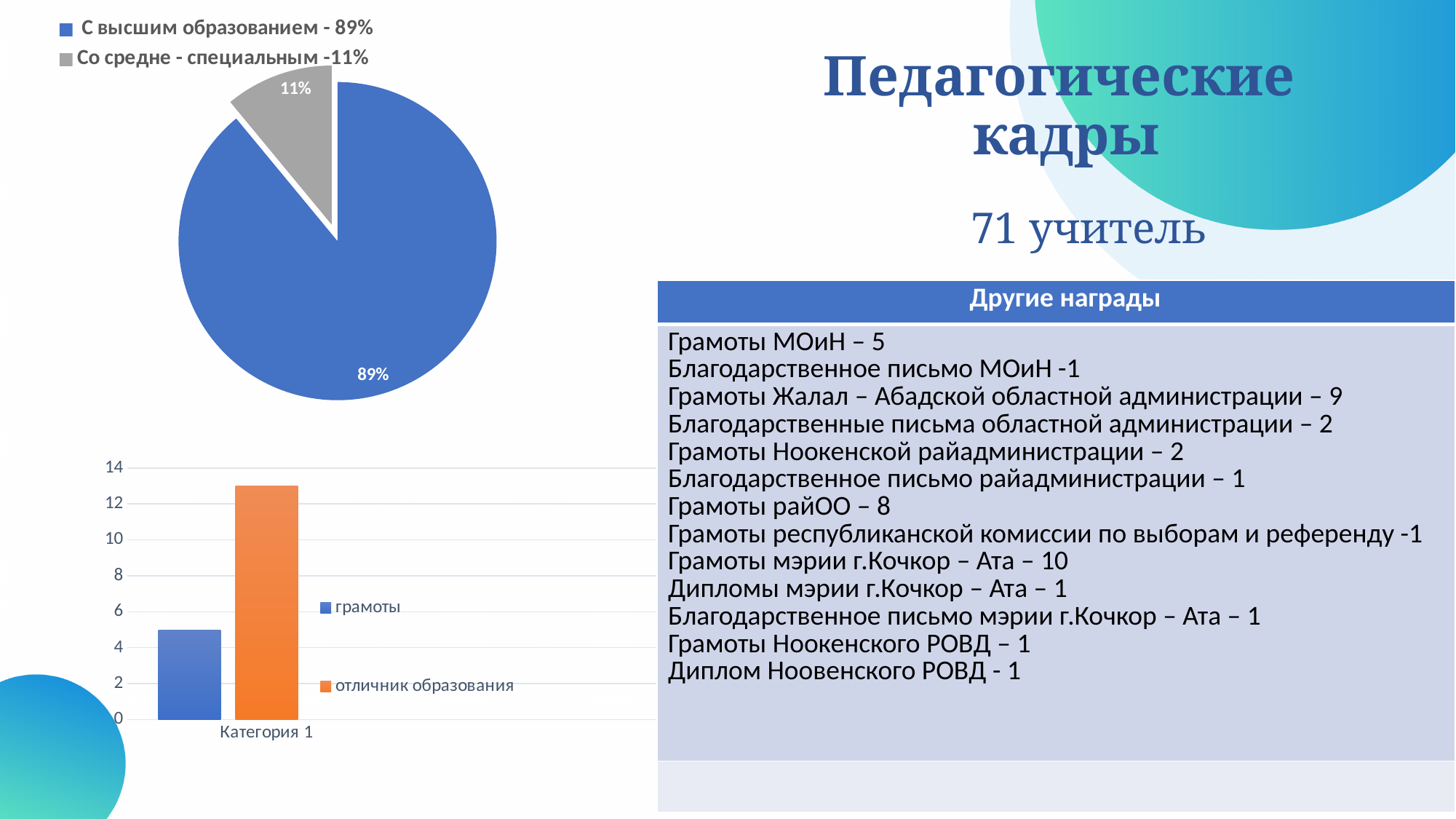
What kind of chart is the top-left chart on the slide? pie chart In the pie chart, what share is labelled for the slice 'Со средне - специальным'? 11% In the bar chart, is the value for 'грамоты' greater or less than 6? less In the bar chart, which series has the taller bar, 'грамоты' or 'отличник образования'? отличник образования What kind of chart is the bottom-left chart on the slide? bar chart In the bar chart, is the value for 'отличник образования' greater or less than 12? greater In the pie chart, what share is labelled for the slice 'С высшим образованием'? 89% In the pie chart, what is the difference in percentage points between the 'С высшим образованием' slice and the 'Со средне - специальным' slice? 78 In the pie chart, which slice is the smallest? Со средне - специальным In the pie chart, which slice is the largest? С высшим образованием In the pie chart, how many slices are there? 2 In the bar chart, how many series does the legend list? 2